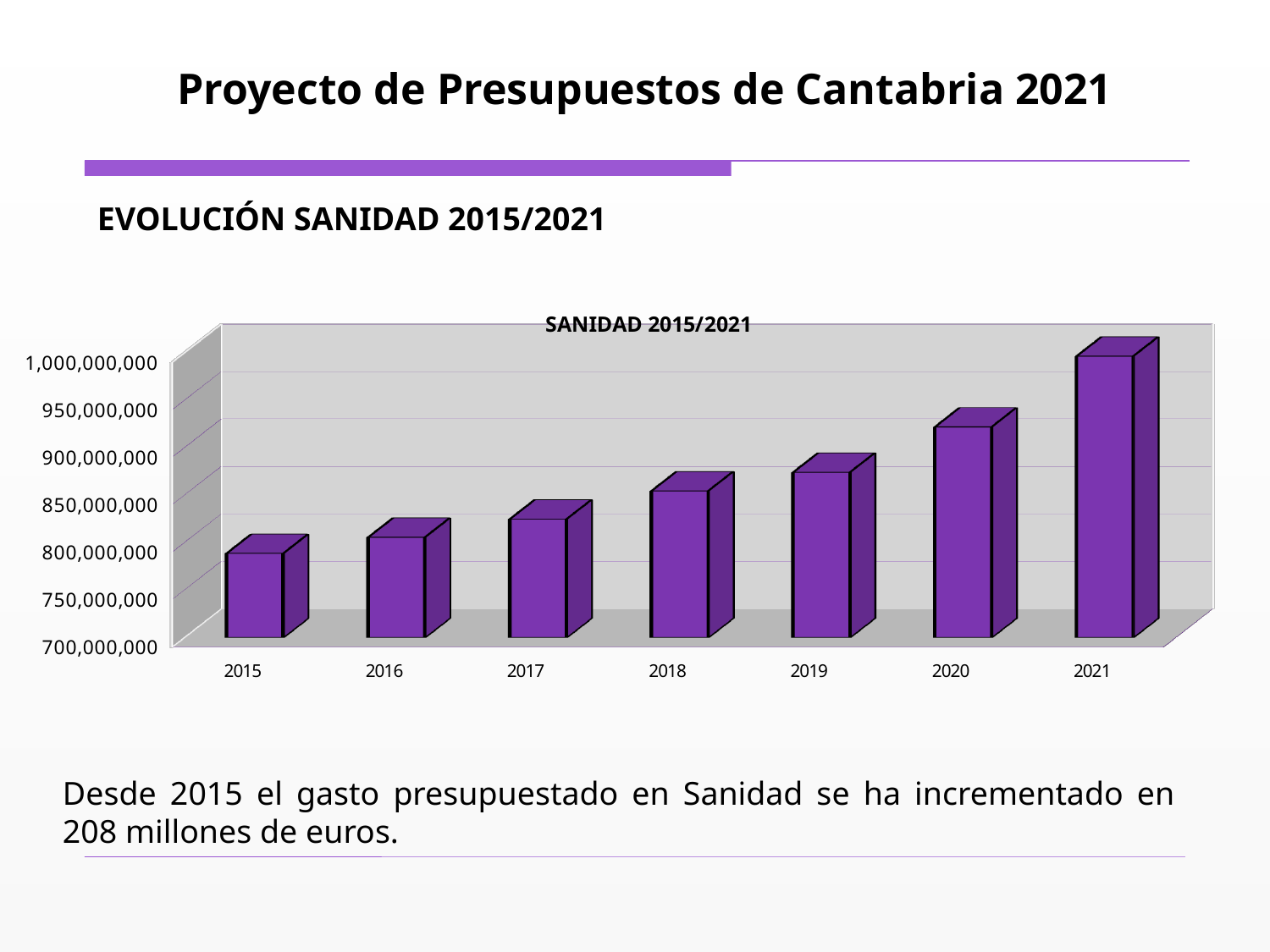
Which is larger, the value for 2018 or the value for 2020? 2020 Is the value for 2019 greater or less than 950,000,000? less Do the values rise or fall from 2015 to 2021? Rise What is the title of the chart? SANIDAD 2015/2021 Is the value for 2015 greater or less than 850,000,000? less What type of chart is shown on the slide? Bar chart How many years are plotted on the chart? 7 Which year has the lowest value on the chart? 2015 Is the value for 2020 greater or less than 900,000,000? greater Which year has the highest value on the chart? 2021